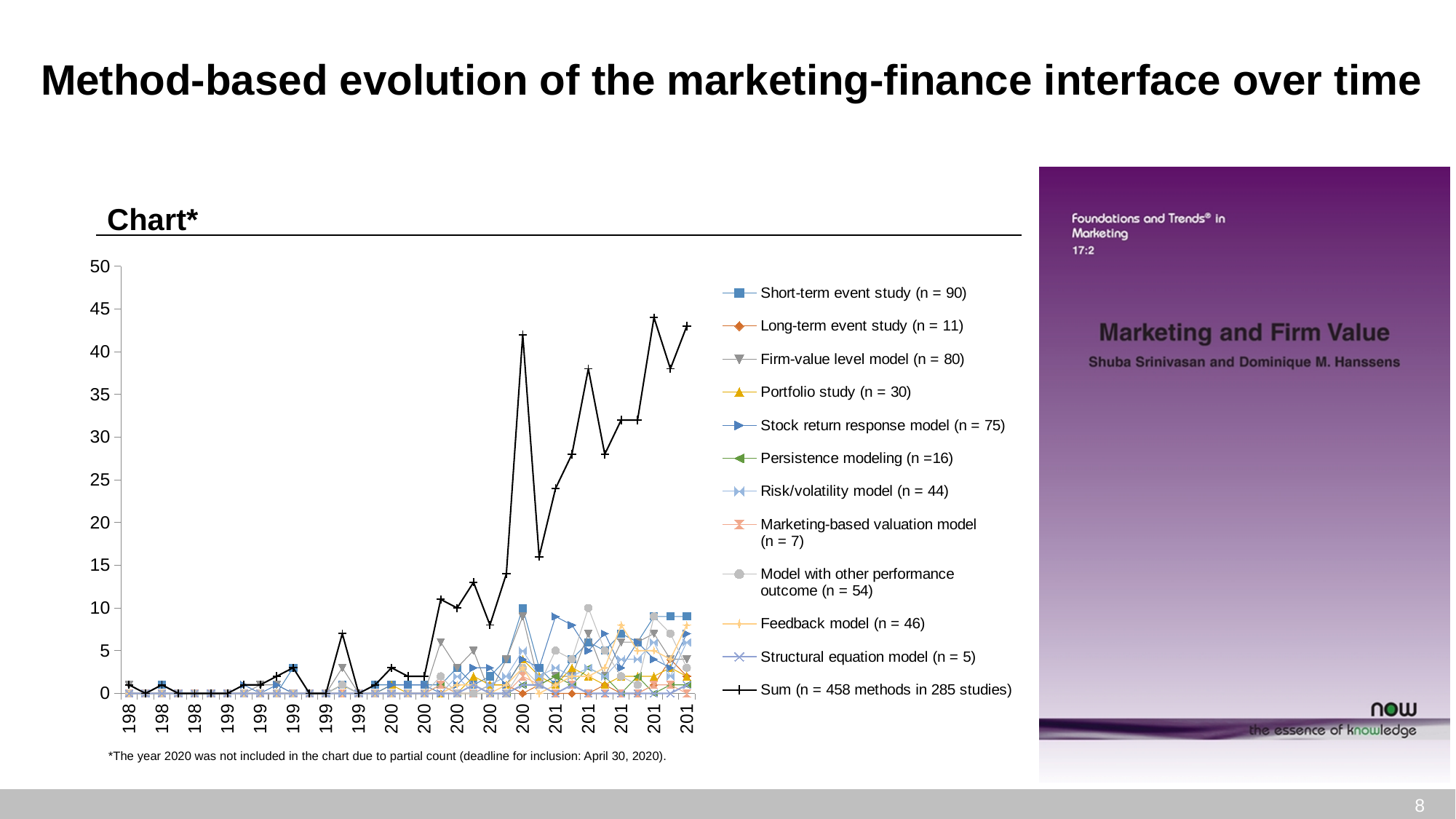
What is the maximum value shown on the chart's y axis? 50 Is the highest point of the Sum line greater or less than 40? greater According to the legend, how many methods and studies does the Sum series cover? n = 458 methods in 285 studies Is the highest point of the Short-term event study series greater or less than 15? less Which series reaches the highest values on the chart? Sum (n = 458 methods in 285 studies) How many series does the chart's legend list? 12 Is the first (leftmost) point of the Sum line greater or less than 5? less What kind of chart is shown on the slide? line chart Does the Sum line generally rise or fall from left to right along the x axis? rise